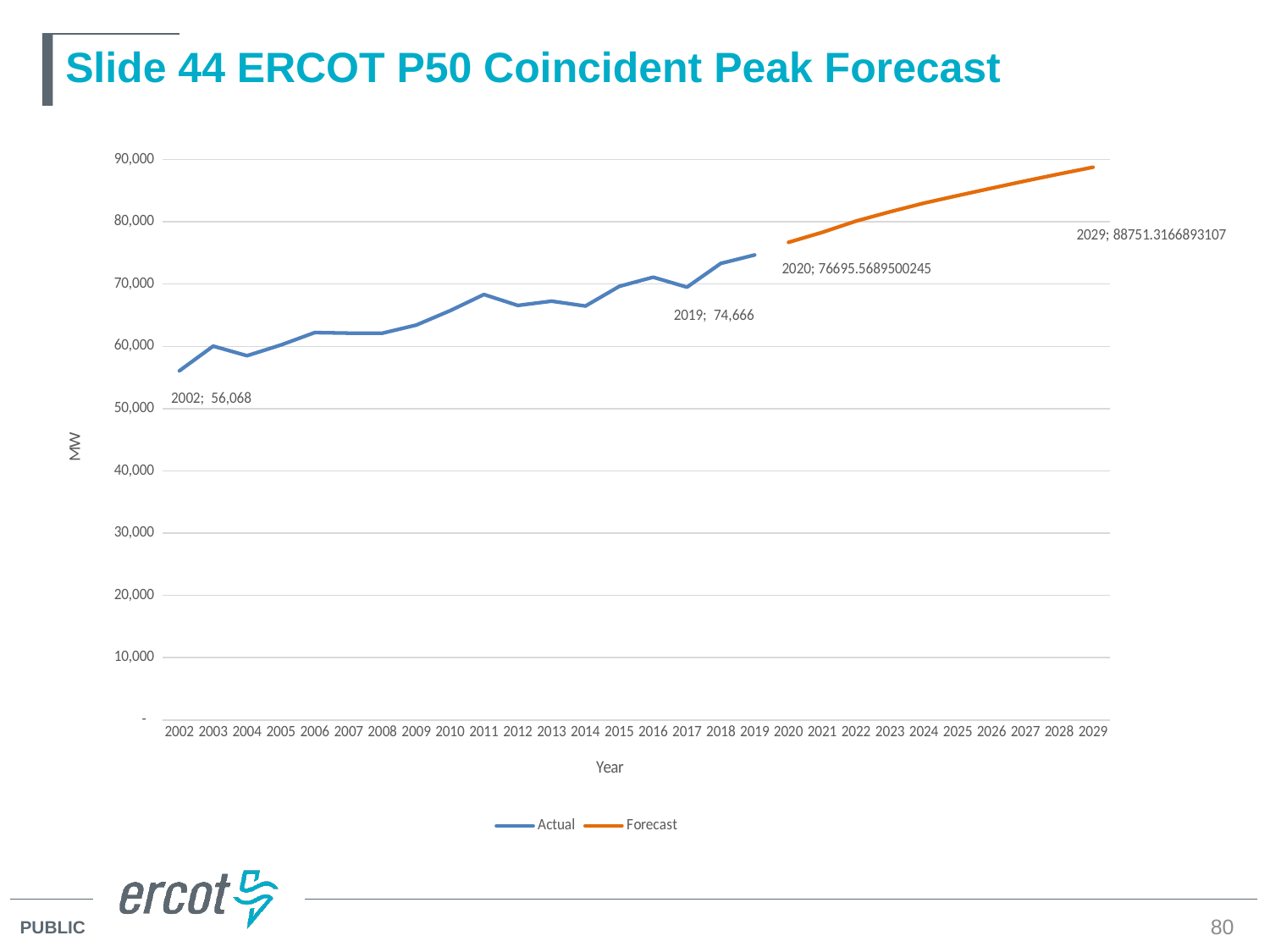
Which year has the highest value on the chart? 2029 Which year has the lowest value on the chart? 2002 What is the value for 2002 on the Actual series? 56,068 Is the value for 2010 greater or less than 70,000? less What is the value labelled for 2029 on the Forecast series? 88751.3166893107 How many series does the legend list? 2 What is the value labelled for 2020 on the Forecast series? 76695.5689500245 Is the value for 2025 greater or less than 80,000? greater What is the difference between the 2019 value and the 2002 value? 18,598 Do the values generally rise or fall from 2002 to 2029? Rise What is the value for 2019 on the Actual series? 74,666 What kind of chart is shown on the slide? Line chart